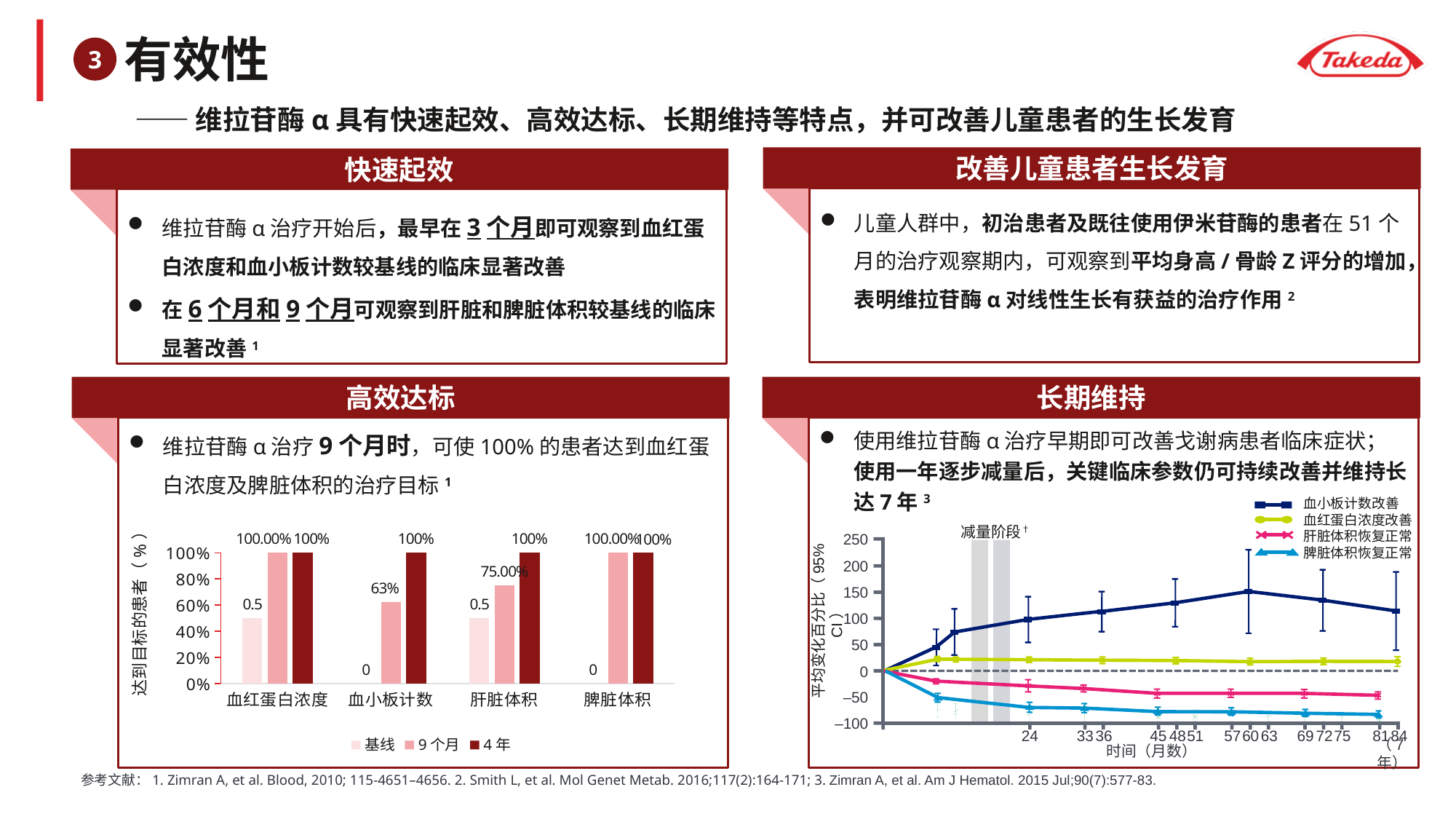
In the line chart in the 长期维持 section, is the value for 血小板计数改善 at 57/60/63 months greater or less than 100? greater In the line chart in the 长期维持 section, is the value for 脾脏体积恢复正常 at 81/84 months greater or less than -50? less In the line chart in the 长期维持 section, how many series does the legend list? 4 In the bar chart in the 高效达标 section, which category has the lowest value in the 9 个月 series? 血小板计数 What kind of chart is shown in the 高效达标 section? bar chart In the bar chart in the 高效达标 section, how many series does the legend list? 3 In the bar chart in the 高效达标 section, what is the difference between the 4 年 value and the 9 个月 value for 血小板计数? 37% In the bar chart in the 高效达标 section, what is the value for 肝脏体积 in the 9 个月 series? 75.00% In the bar chart in the 高效达标 section, how many categories are shown on the x axis? 4 In the bar chart in the 高效达标 section, what is the value for 脾脏体积 in the 基线 series? 0 In the bar chart in the 高效达标 section, what is the value for 血红蛋白浓度 in the 基线 series? 0.5 In the bar chart in the 高效达标 section, what is the value for 血小板计数 in the 9 个月 series? 63%